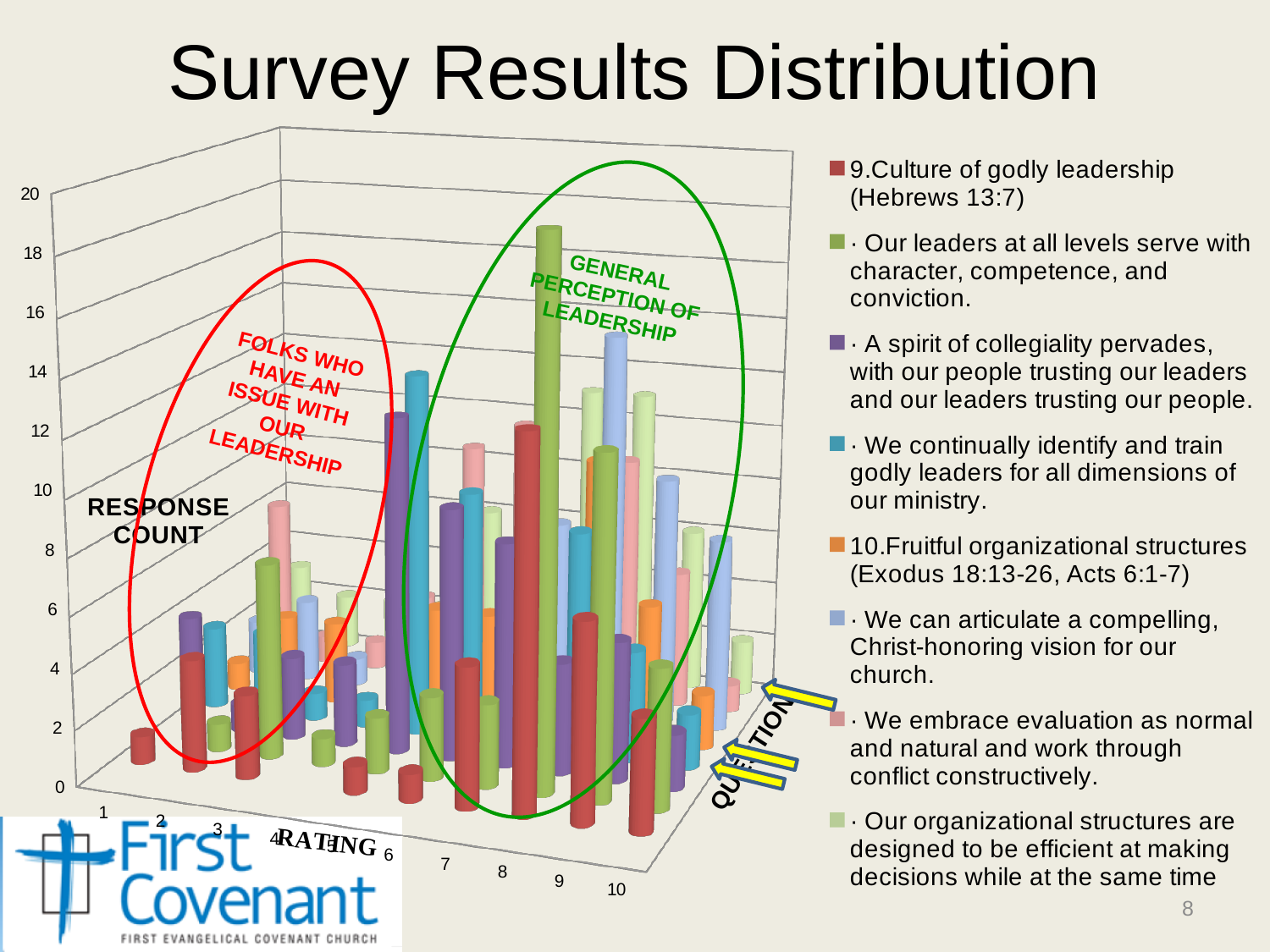
What kind of chart is shown on the slide? bar chart Are the response counts in the chart generally higher for low ratings (1-6) or for high ratings (7-10)? high ratings What is the highest value shown on the vertical axis of the chart? 20 Is the tallest bar in the chart greater or less than 10? greater What is the title of the slide's chart? Survey Results Distribution How many rating categories are shown along the x axis of the chart? 10 What label is given to the vertical axis of the chart? RESPONSE COUNT Which rating range has the taller bars overall: ratings 1-3 or ratings 8-10? ratings 8-10